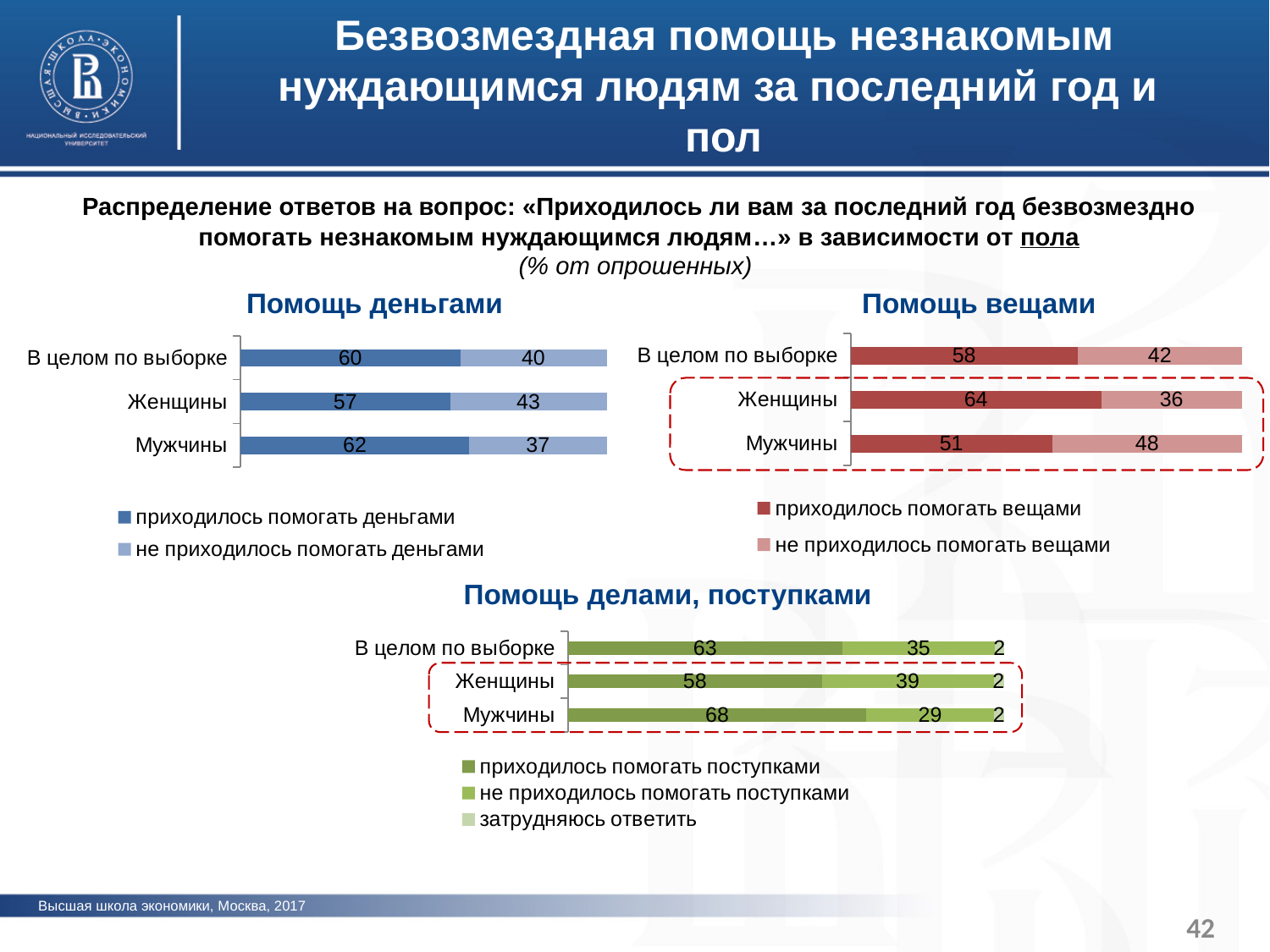
In the chart titled «Помощь вещами», which category has the lowest value for «приходилось помогать вещами»? Мужчины In the chart titled «Помощь делами, поступками», how many series does the legend list? 3 In the chart titled «Помощь деньгами», which category has the highest value for «приходилось помогать деньгами»? Мужчины In the chart titled «Помощь деньгами», what is the value for «не приходилось помогать деньгами» for «Мужчины»? 37 What kind of chart is the chart titled «Помощь деньгами»? Stacked bar chart In the chart titled «Помощь делами, поступками», is the «приходилось помогать поступками» value for «Мужчины» larger or smaller than that for «Женщины»? larger In the chart titled «Помощь делами, поступками», what is the value for «не приходилось помогать поступками» for «Женщины»? 39 How many categories are shown in the chart titled «Помощь вещами»? 3 In the chart titled «Помощь деньгами», what is the value for «приходилось помогать деньгами» for «Женщины»? 57 In the chart titled «Помощь вещами», what is the difference between the «приходилось помогать вещами» values for «Женщины» and «Мужчины»? 13 In the chart titled «Помощь вещами», what is the value for «приходилось помогать вещами» for «Мужчины»? 51 In the chart titled «Помощь делами, поступками», what is the total of the stacked bar for «Мужчины»? 99